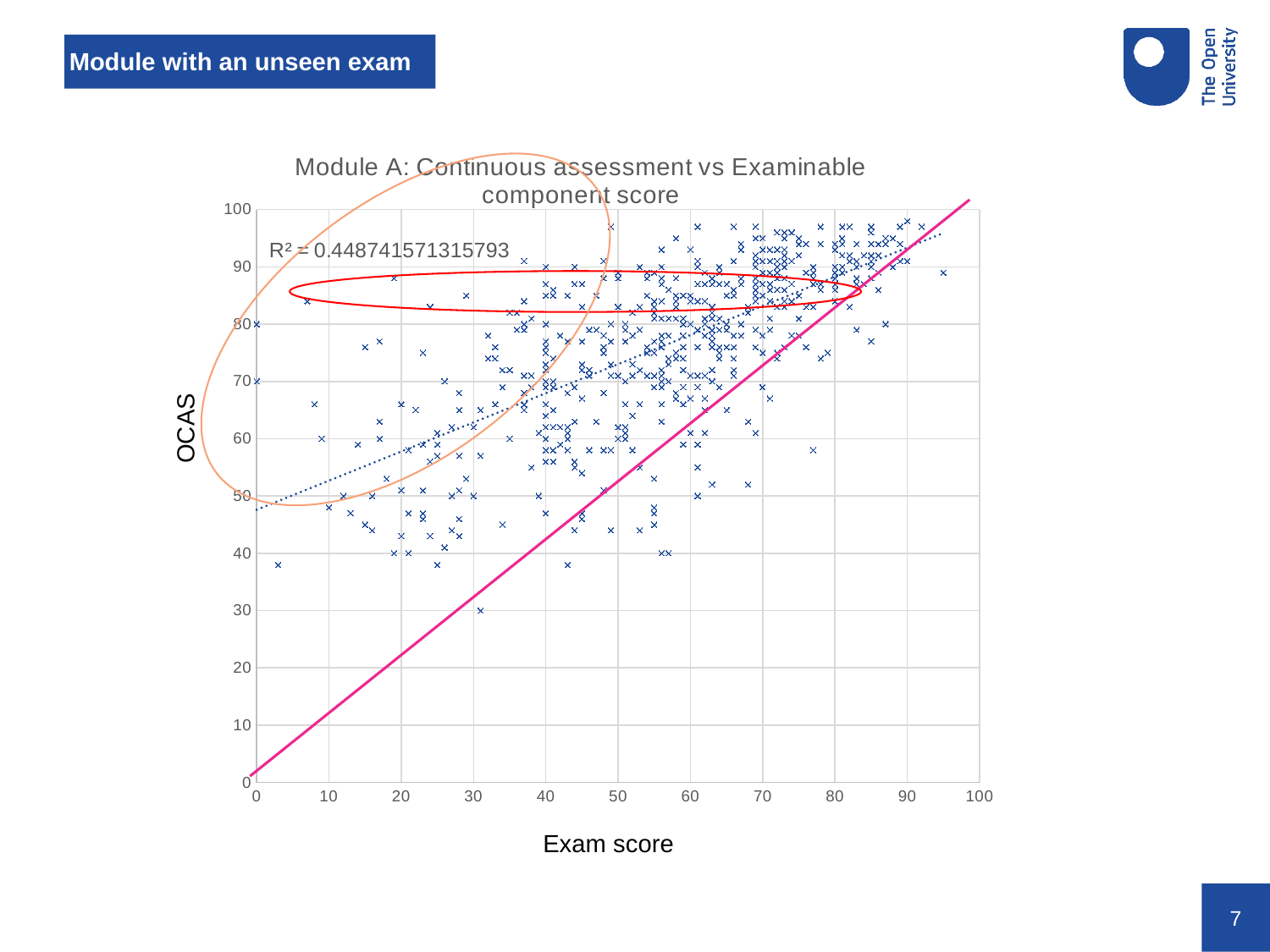
What R² value is printed on the chart? 0.448741571315793 Is the lowest OCAS value plotted on the chart greater or less than 40? less Is the OCAS value of the dotted trendline at an exam score of 90 greater or less than 80? greater What is the label of the horizontal axis of the chart? Exam score What is the title of the chart? Module A: Continuous assessment vs Examinable component score What kind of chart is shown on the slide? scatter chart Is the highest exam score plotted on the chart greater or less than 90? greater What is the highest value shown on the OCAS axis of the chart? 100 Does the dotted trendline on the chart rise or fall as the exam score increases? rise